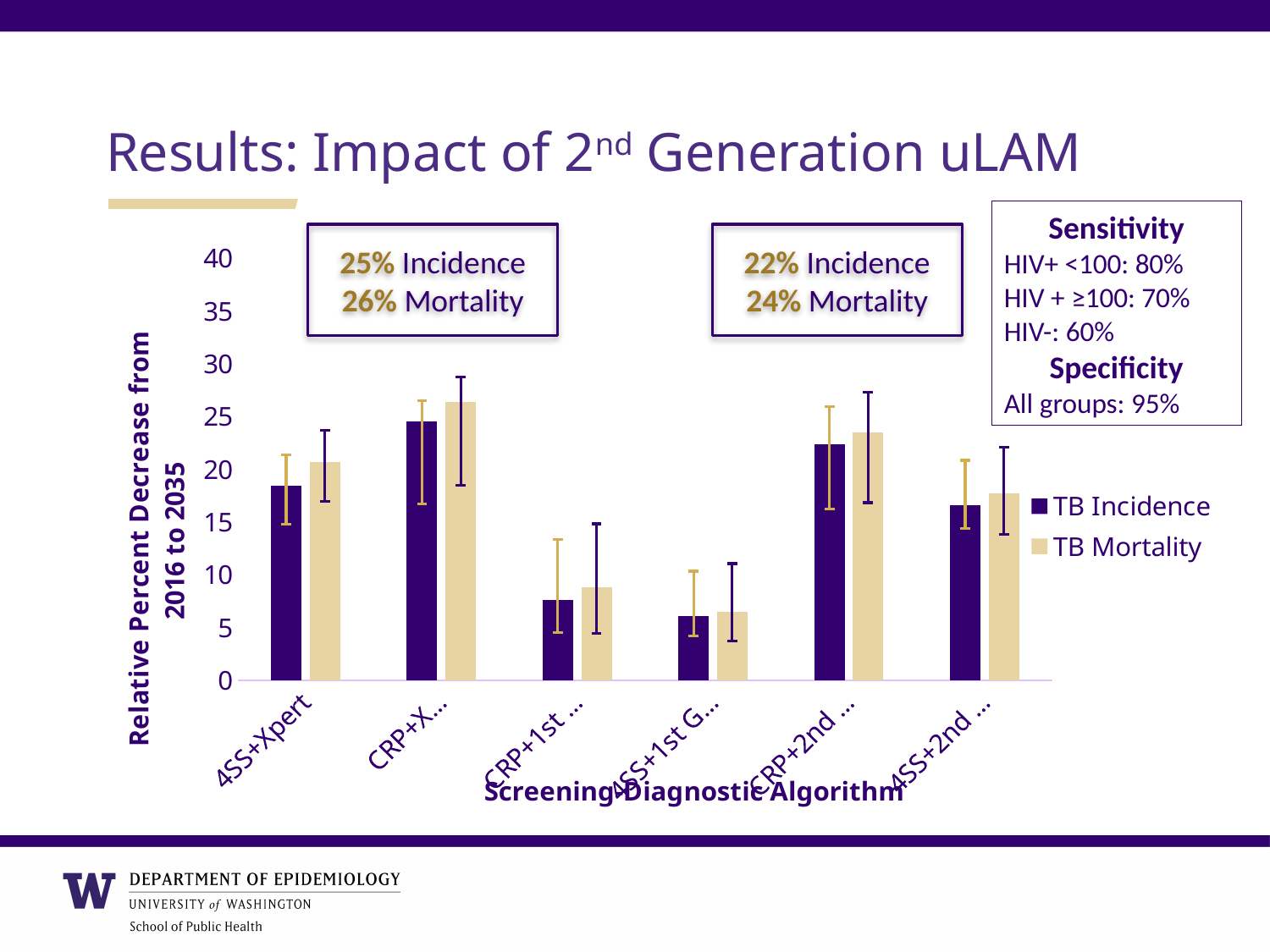
Which category has the highest TB Incidence bar? CRP+X... How many series does the chart legend list? 2 What kind of chart is shown on the slide? bar chart Is the TB Mortality value for CRP+2nd ... greater or less than 20? greater How many screening-diagnostic algorithm categories are plotted on the x axis? 6 Which is larger, the TB Incidence value for 4SS+Xpert or the TB Incidence value for 4SS+1st G...? 4SS+Xpert Is the TB Incidence value for 4SS+Xpert greater or less than 15? greater What is the title of the chart's y axis? Relative Percent Decrease from 2016 to 2035 What are the two entries in the chart legend? TB Incidence and TB Mortality Is the TB Incidence value for CRP+1st ... greater or less than 10? less Which category has the lowest TB Mortality bar? 4SS+1st G...